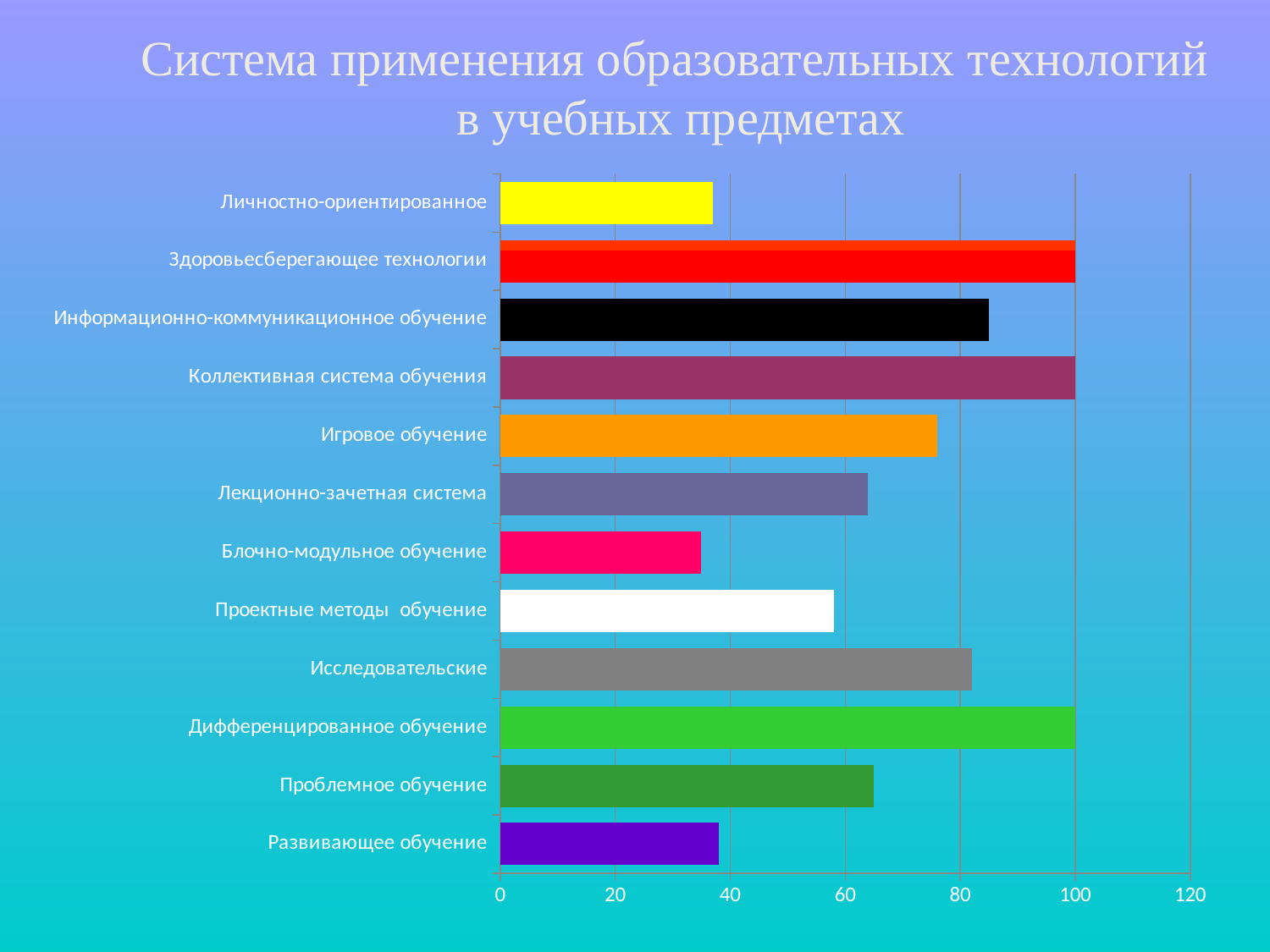
Is the value for Информационно-коммуникационное обучение greater or less than 80? greater Is the value for Проблемное обучение greater or less than 60? greater How many categories are plotted in the chart? 12 Is the value for Блочно-модульное обучение greater or less than 40? less Which is larger, the value for Игровое обучение or the value for Лекционно-зачетная система? Игровое обучение What kind of chart is shown on the slide? bar chart What is the value for Здоровьесберегающее технологии? 100 What is the value for Дифференцированное обучение? 100 What is the value for Коллективная система обучения? 100 Which is larger, the value for Информационно-коммуникационное обучение or the value for Проектные методы обучение? Информационно-коммуникационное обучение